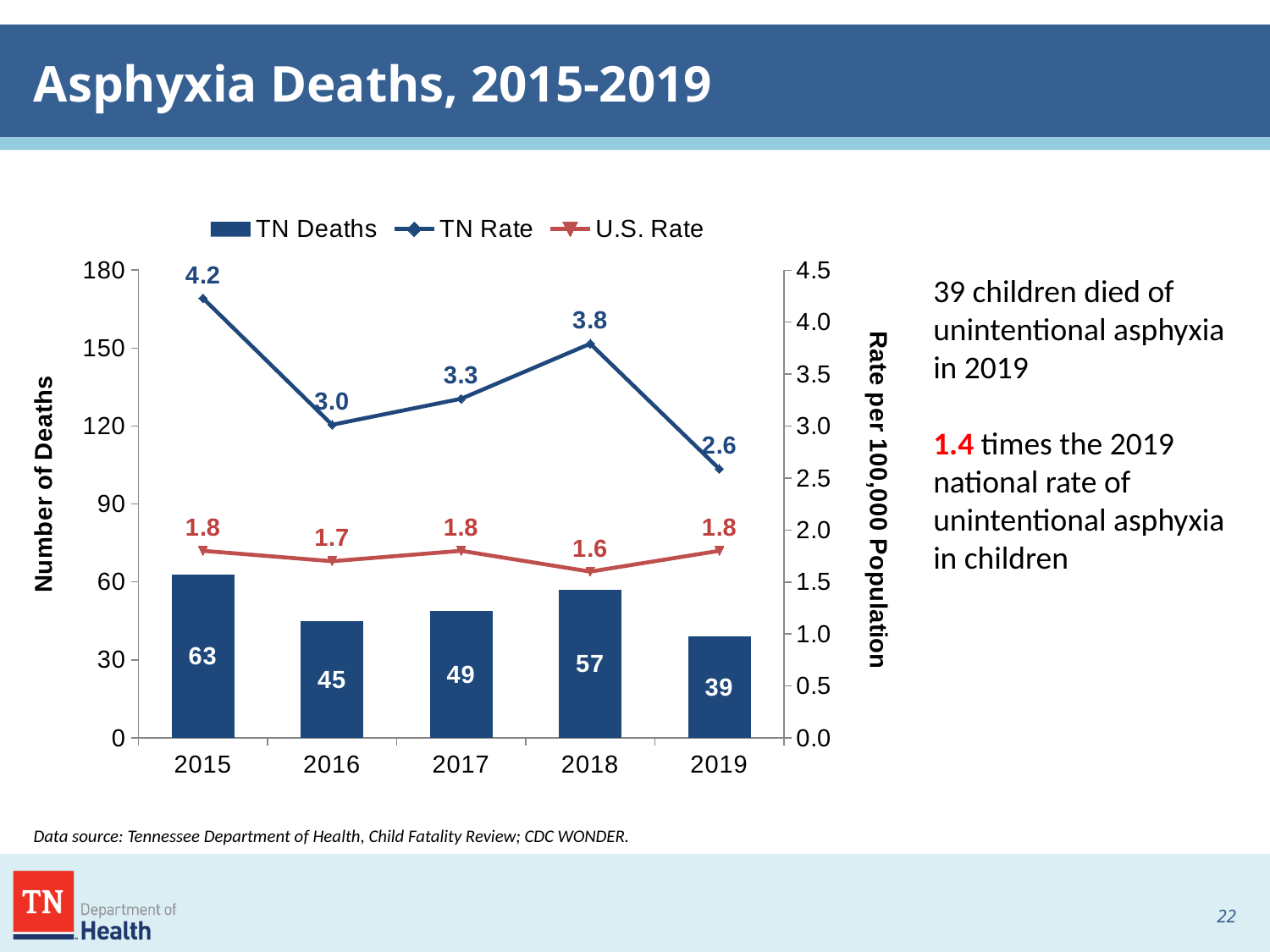
What is the title of the slide's chart? Asphyxia Deaths, 2015-2019 How many series does the legend list? 3 What is the difference between the TN Rate and the U.S. Rate in 2015? 2.4 Which year had the lowest TN Rate? 2019 What was the TN Rate in 2018? 3.8 What is the difference between TN Deaths in 2018 and 2019? 18 What was the U.S. Rate in 2016? 1.7 How many TN Deaths were there in 2015? 63 Which is larger, the TN Deaths in 2016 or in 2017? 2017 How many years are shown on the x axis? 5 Does the TN Rate rise or fall from 2018 to 2019? fall Which year had the highest number of TN Deaths? 2015